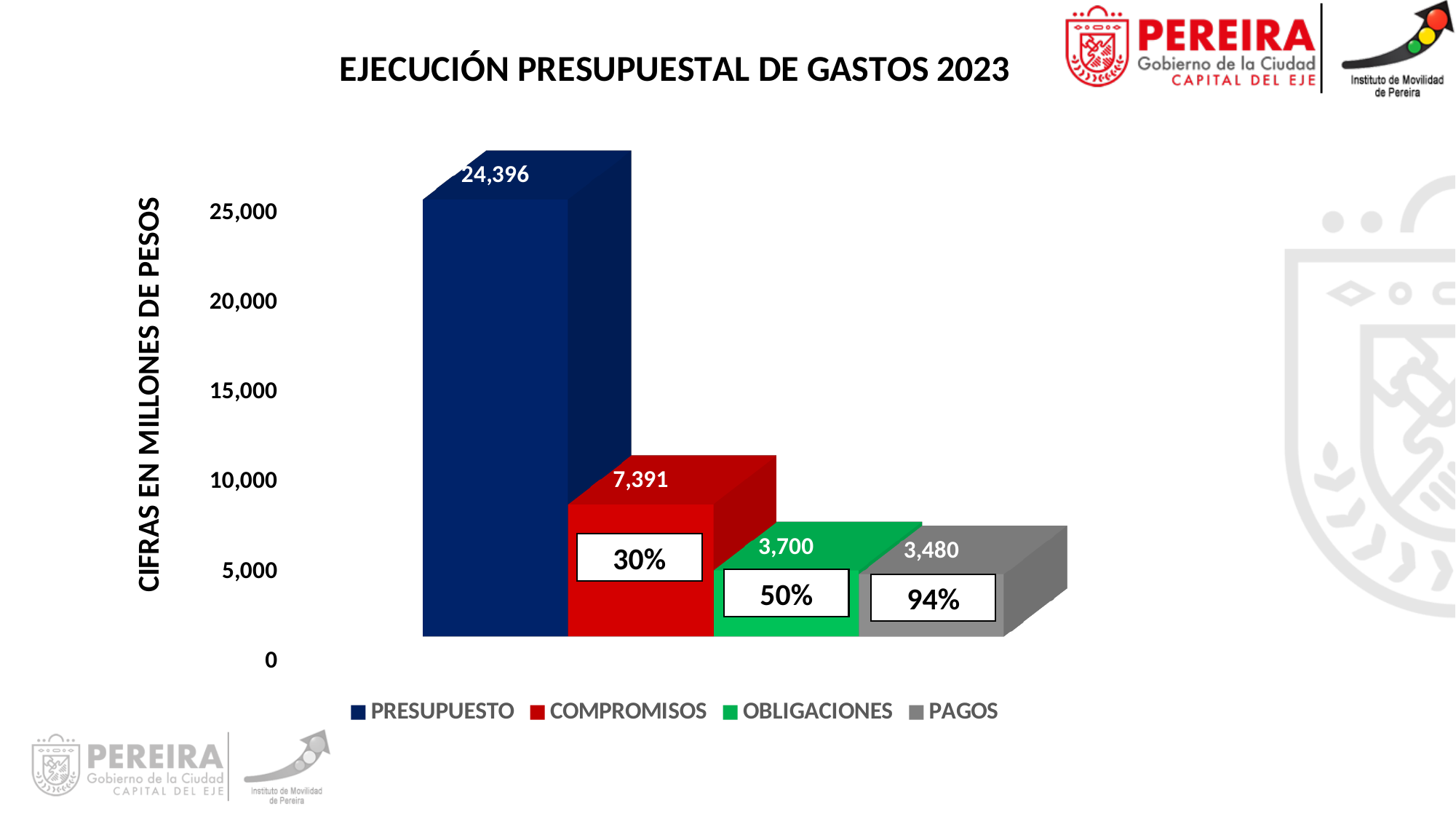
What is the difference between OBLIGACIONES and PAGOS? 220 What is the value for PRESUPUESTO? 24,396 What is the difference between PRESUPUESTO and COMPROMISOS? 17,005 Which is larger, COMPROMISOS or OBLIGACIONES? COMPROMISOS Which series has the highest value? PRESUPUESTO Which series has the lowest value? PAGOS What is the value for OBLIGACIONES? 3,700 How many series does the legend list? 4 What kind of chart is shown on the slide? Bar chart What is the title of the chart? EJECUCIÓN PRESUPUESTAL DE GASTOS 2023 What is the value for COMPROMISOS? 7,391 What is the value for PAGOS? 3,480